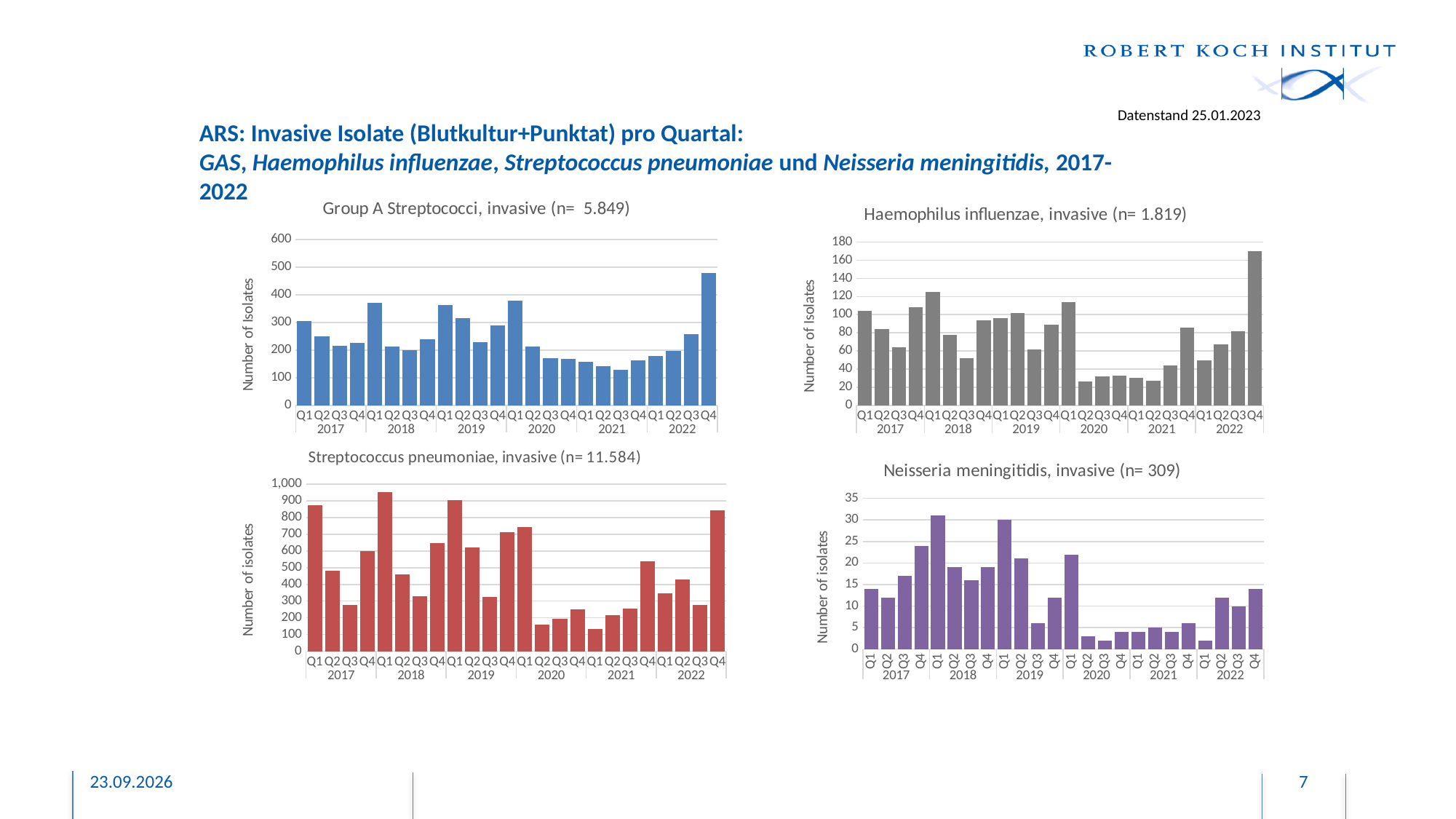
In the Streptococcus pneumoniae chart, which quarter has the highest number of isolates? Q1 2018 In the Group A Streptococci chart, which quarter has the highest number of isolates? Q4 2022 In the Group A Streptococci chart, is the value for Q3 2021 greater or less than 200? less In the Group A Streptococci chart, is the value for Q4 2022 greater or less than 400? greater How many quarterly bars are plotted in the Group A Streptococci chart? 24 In the Neisseria meningitidis chart, do the values generally rise or fall from Q1 2021 to Q4 2022? rise In the Neisseria meningitidis chart, is the value for Q3 2020 greater or less than 5? less In the Streptococcus pneumoniae chart, which is larger, the value for Q1 2018 or Q1 2019? Q1 2018 What total number of isolates (n) is given in the title of the Streptococcus pneumoniae chart? 11.584 In the Haemophilus influenzae chart, which quarter has the highest number of isolates? Q4 2022